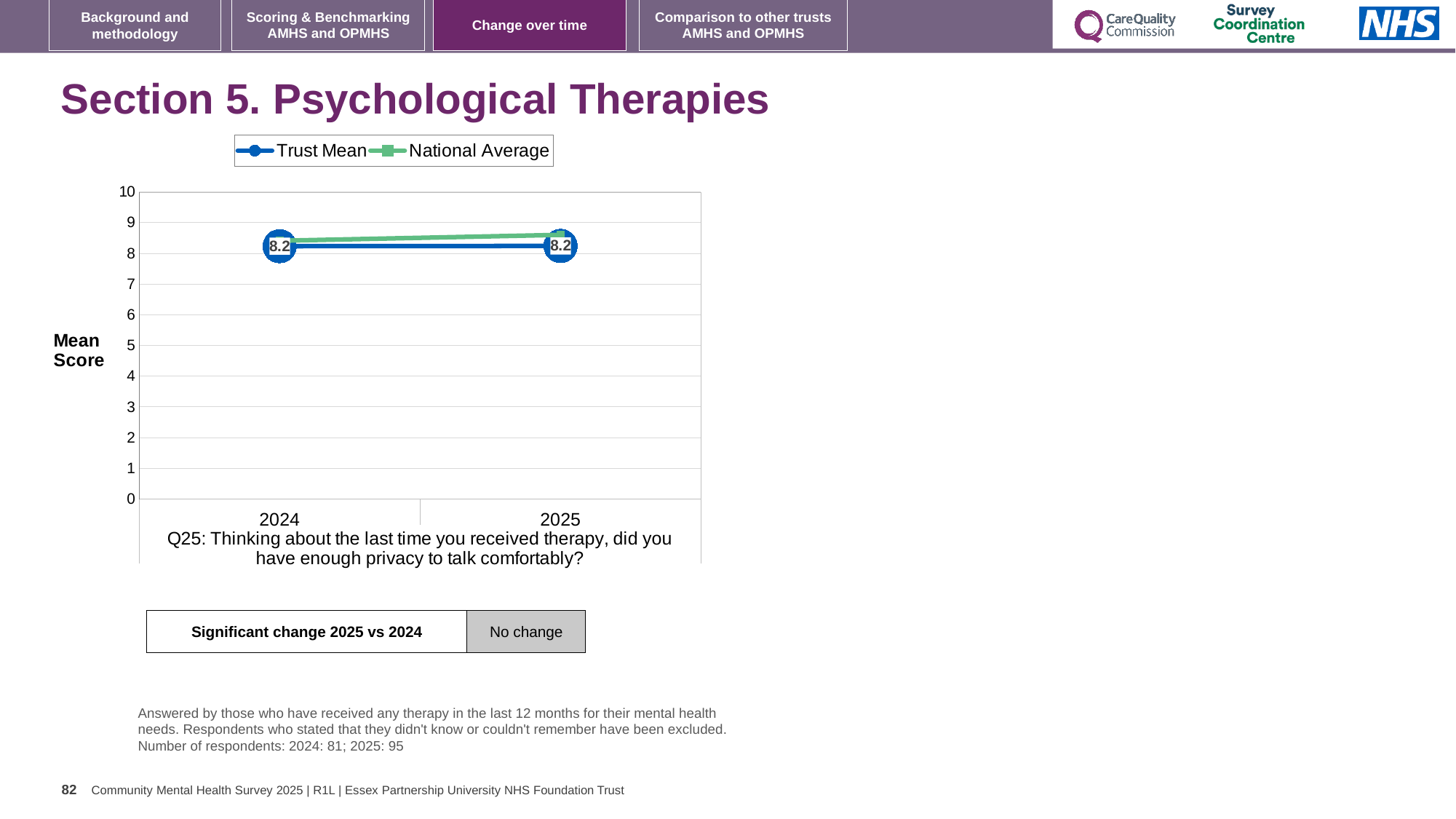
What is the Trust Mean value for 2024? 8.2 How many series does the legend list? 2 Is the National Average value for 2025 greater or less than 8? greater What does the table below the chart say about the significant change 2025 vs 2024? No change What is the Trust Mean value for 2025? 8.2 What kind of chart is shown on the slide? Line chart Is the National Average value for 2024 greater or less than 9? less How many years are plotted on the x axis? 2 What is the difference between the Trust Mean in 2025 and the Trust Mean in 2024? 0 Does the Trust Mean rise, fall or stay the same from 2024 to 2025? Stays the same In 2025, which is higher: the Trust Mean or the National Average? National Average What is the label on the y axis of the chart? Mean Score